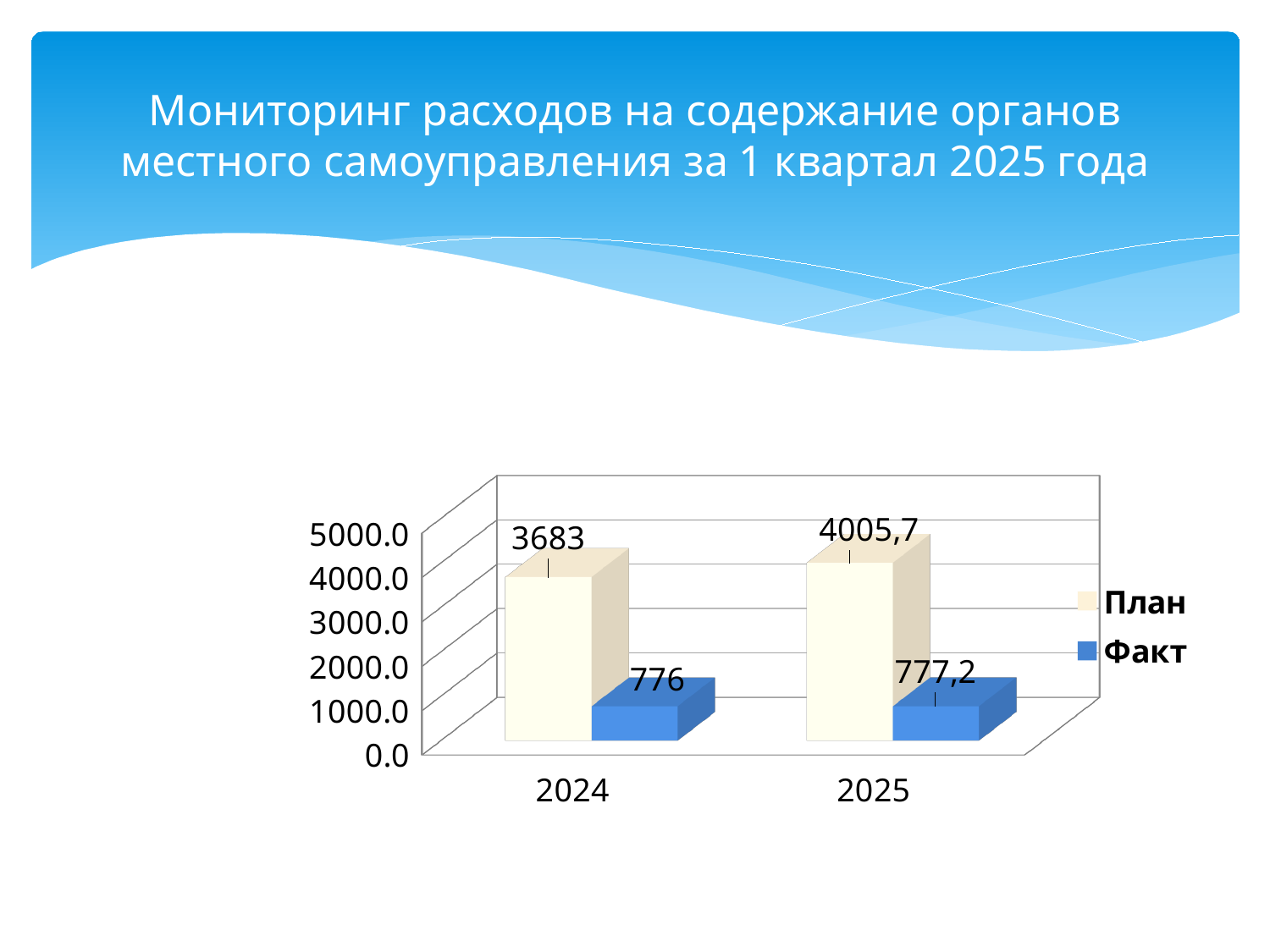
Does the План value rise or fall from 2024 to 2025? rise What is the План value for 2024? 3683 Which year has the higher План value? 2025 What is the План value for 2025? 4005,7 How many series does the legend list? 2 What is the difference between the План and Факт values for 2024? 2907 What is the difference between the План values for 2025 and 2024? 322,7 What is the Факт value for 2024? 776 What kind of chart is shown on the slide? bar chart Is the Факт value for 2024 greater or less than 1000.0? less Which is larger for 2025, План or Факт? План What is the Факт value for 2025? 777,2